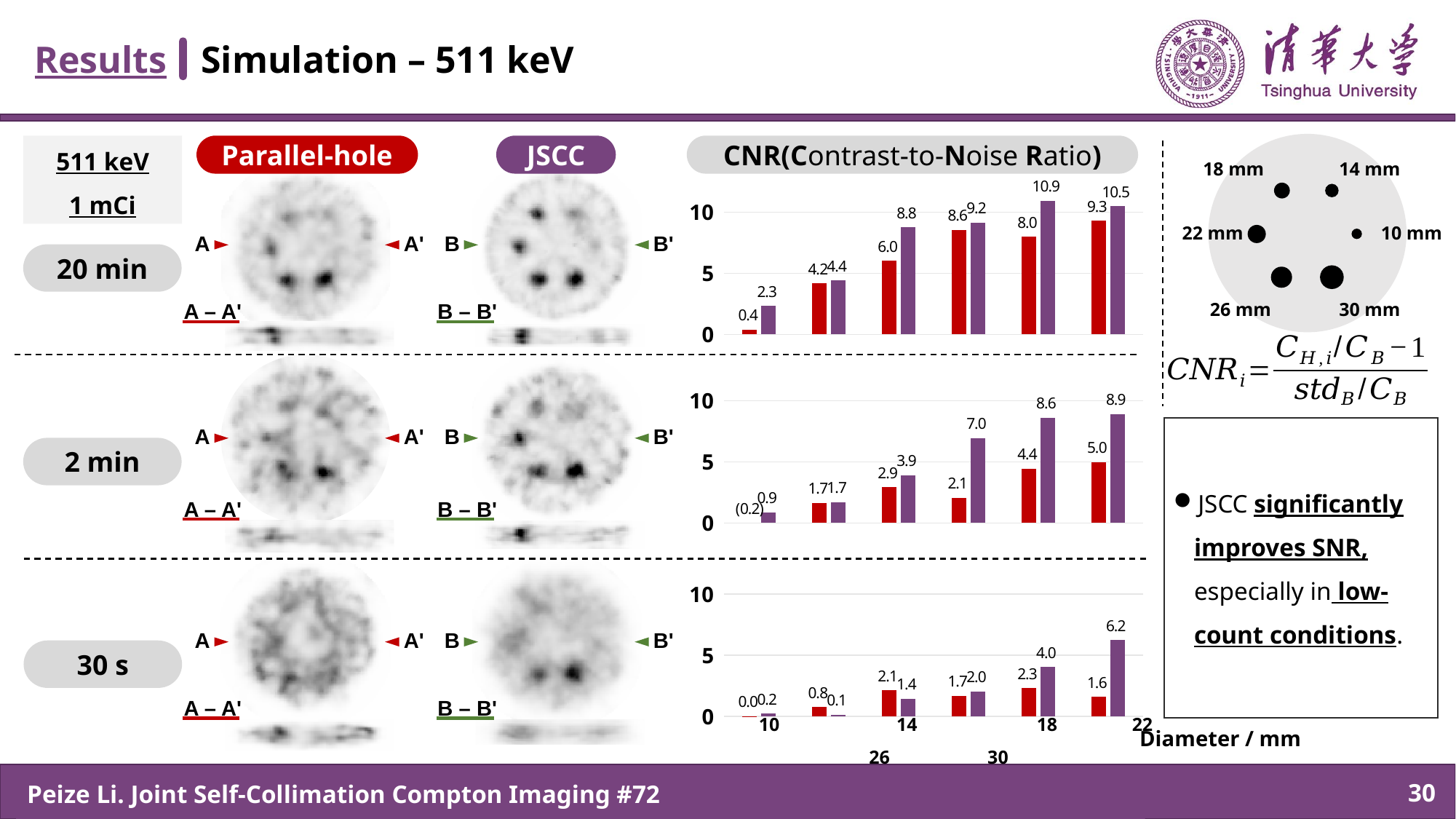
In the 2 min CNR chart, what is the highest JSCC (purple) value shown? 8.9 In the 30 s CNR chart, what is the difference between the JSCC and Parallel-hole values in the rightmost group of bars? 4.6 In the 20 min CNR chart, what is the difference between the JSCC and Parallel-hole values in the rightmost group of bars? 1.2 In the 20 min CNR chart, what is the Parallel-hole (red) value for the leftmost group of bars? 0.4 In the 2 min CNR chart, do the JSCC (purple) values rise or fall from left to right along the x axis? Rise In the 20 min CNR chart, what is the highest JSCC (purple) value shown? 10.9 In the 2 min CNR chart, what is the Parallel-hole (red) value for the rightmost group of bars? 5.0 In the 2 min CNR chart, in the fourth group of bars from the left, which is larger: the Parallel-hole value or the JSCC value? JSCC In the 30 s CNR chart, what is the highest JSCC (purple) value shown? 6.2 What type of chart is used to show the CNR results on this slide? Bar chart In the 30 s CNR chart, what is the lowest Parallel-hole (red) value shown? 0.0 How many groups of bars (diameter categories) does each CNR chart contain? 6